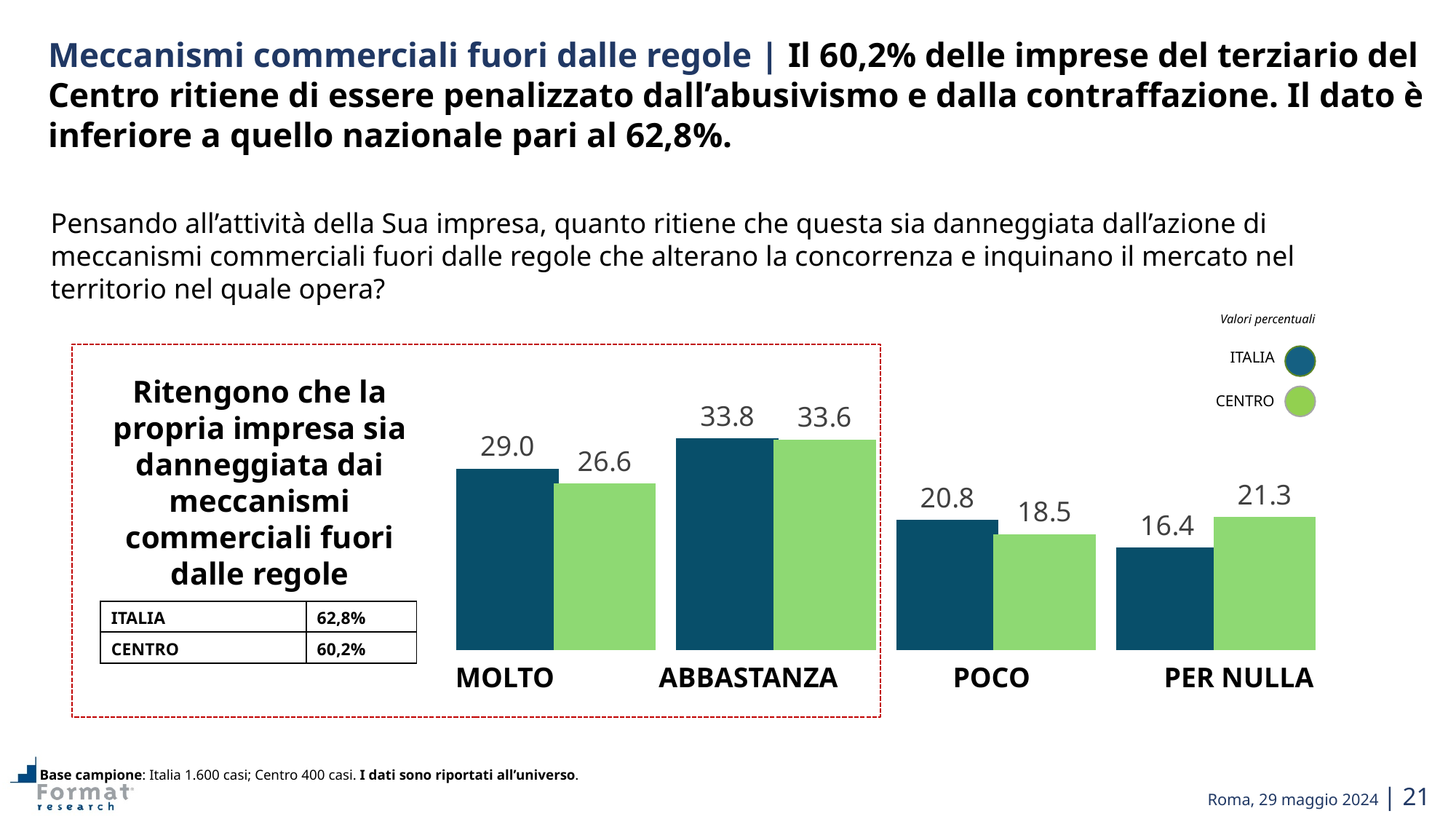
What is the CENTRO value for POCO? 18.5 What is the difference between the CENTRO and ITALIA values for PER NULLA? 4.9 What is the CENTRO value for PER NULLA? 21.3 Which category has the highest ITALIA value? ABBASTANZA How many series does the legend list? 2 What kind of chart is shown on the slide? bar chart Which category has the lowest CENTRO value? POCO Which category has the lowest ITALIA value? PER NULLA What is the difference between the ITALIA and CENTRO values for MOLTO? 2.4 What is the ITALIA value for MOLTO? 29.0 How many categories are shown on the x axis? 4 For POCO, which series has the larger value, ITALIA or CENTRO? ITALIA